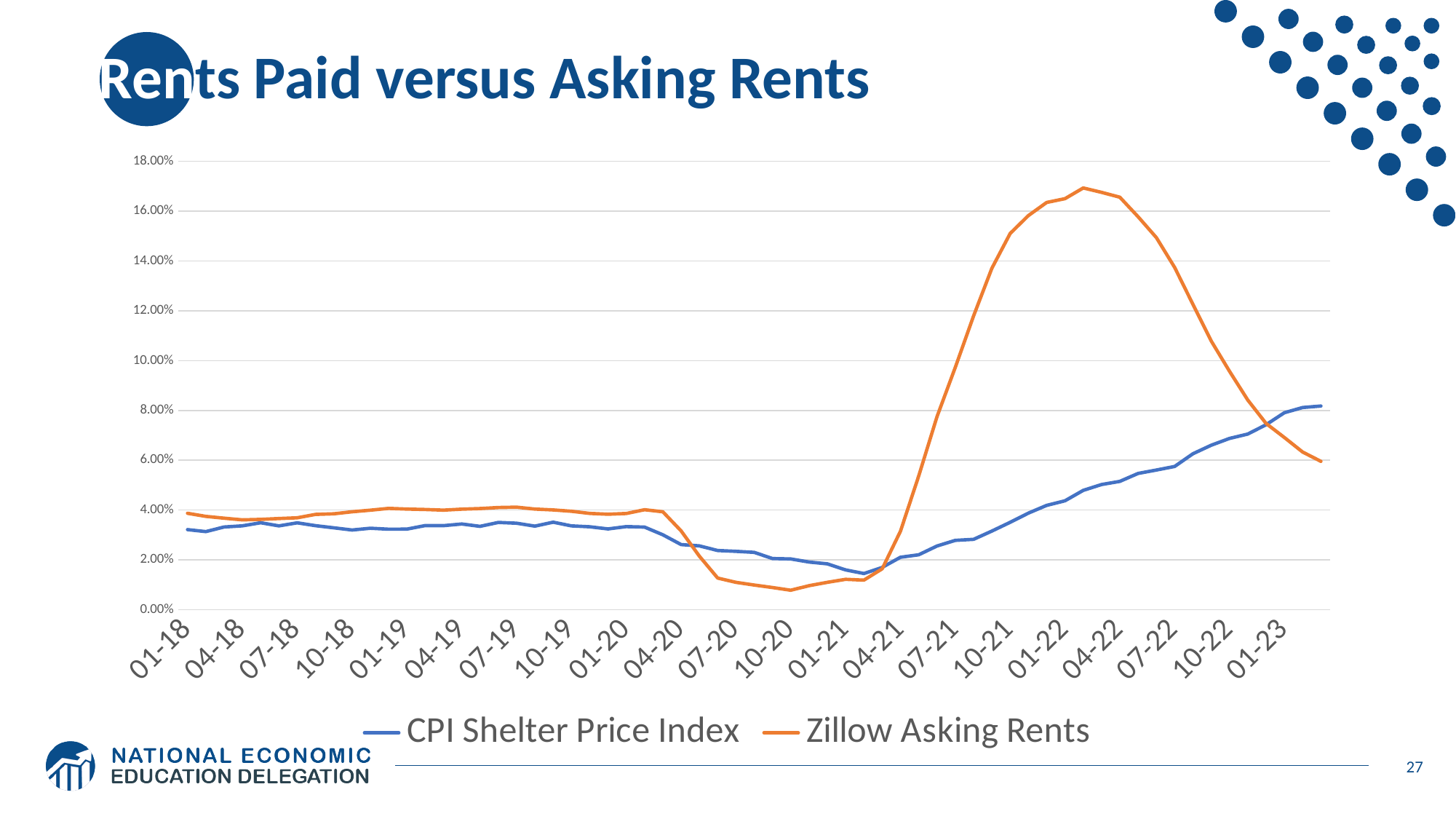
What kind of chart is shown on the slide? line chart Is the value for Zillow Asking Rents at 01-22 greater or less than 14.00%? greater Which series reaches the highest value anywhere on the chart? Zillow Asking Rents What is the title of the chart on the slide? Rents Paid versus Asking Rents Which series is drawn in orange? Zillow Asking Rents How many series does the legend list? 2 At 01-23, which series has the higher value, CPI Shelter Price Index or Zillow Asking Rents? CPI Shelter Price Index Is the value for CPI Shelter Price Index at 01-23 greater or less than 6.00%? greater Is the value for Zillow Asking Rents at 10-20 greater or less than 2.00%? less Does the Zillow Asking Rents line rise or fall between 04-22 and 01-23? fall At 01-22, which series has the higher value, CPI Shelter Price Index or Zillow Asking Rents? Zillow Asking Rents